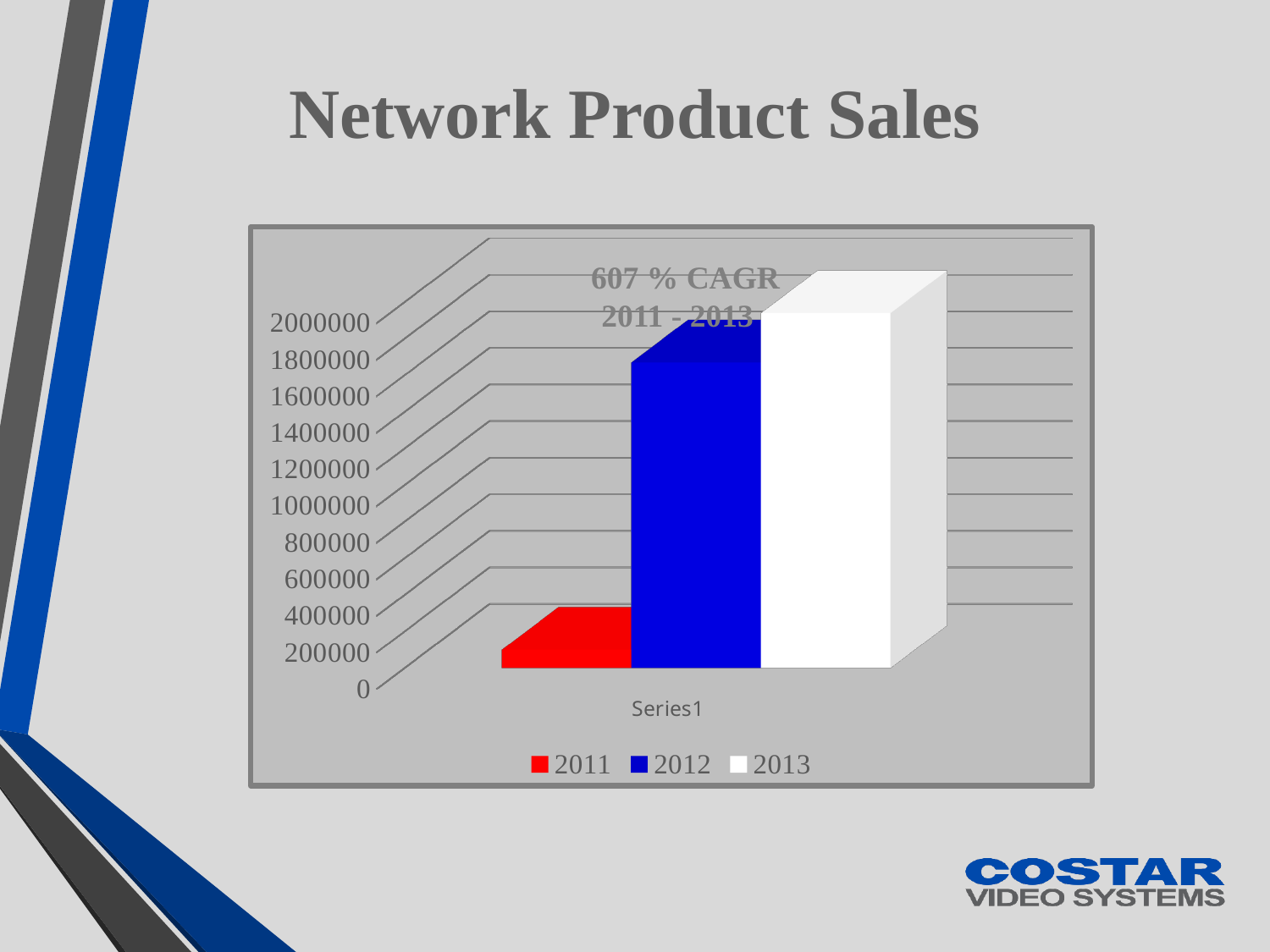
What kind of chart is shown on the slide? bar chart How many bars are plotted in the chart? 3 Is the value for 2012 greater or less than 1000000? greater Do the values rise or fall from 2011 to 2013? rise Is the value for 2013 greater or less than 1600000? greater Which is larger, the value for 2012 or the value for 2011? 2012 Which year has the highest bar? 2013 Which year has the lowest bar? 2011 Is the value for 2011 greater or less than 400000? less What is the title of the slide's chart? Network Product Sales What CAGR figure is annotated on the chart? 607 % CAGR 2011 - 2013 How many series does the legend list? 3